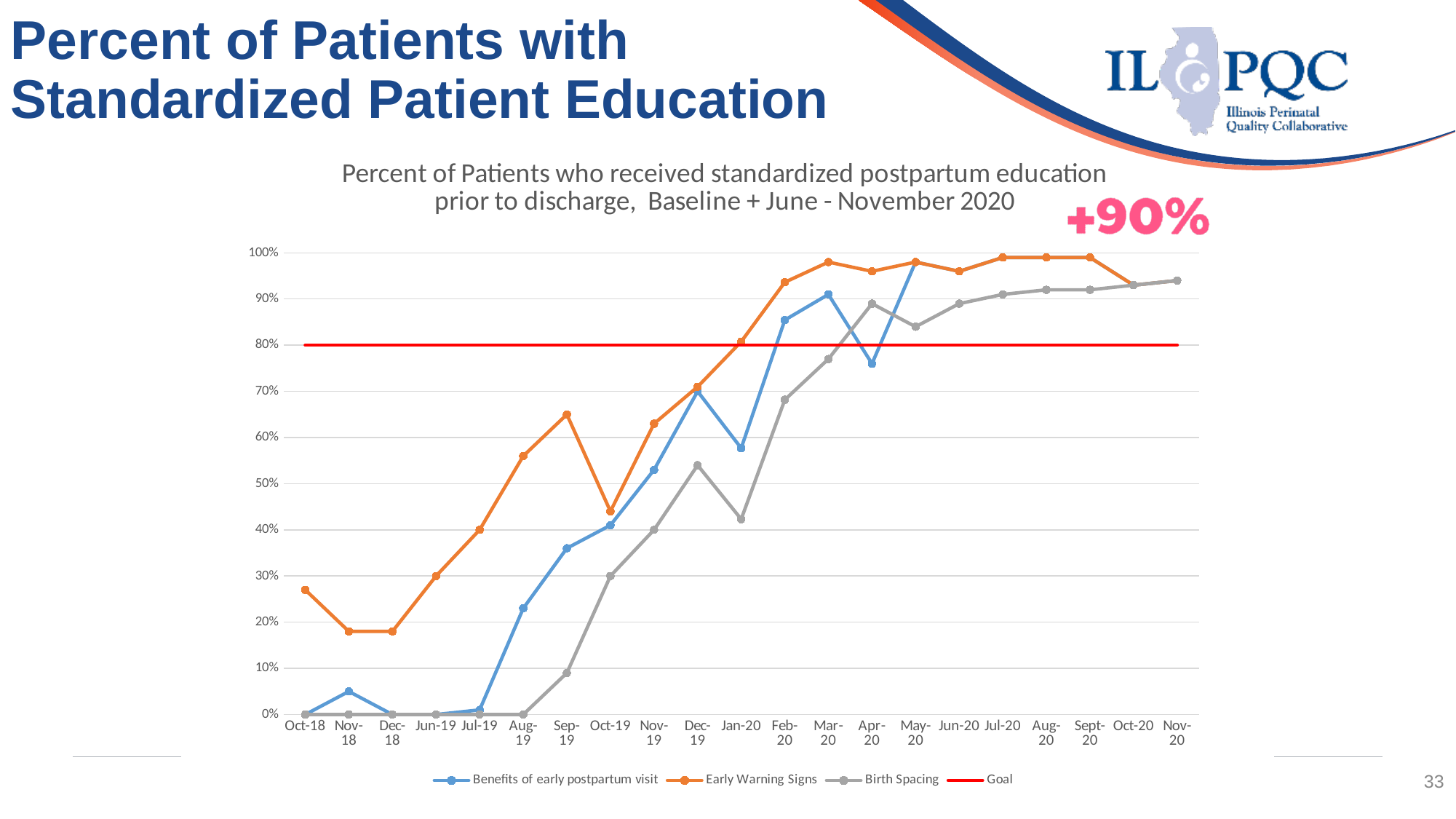
At what percentage is the Goal line drawn? 80% Does the Birth Spacing line generally rise or fall from Oct-18 to Nov-20? rise Is the value for Early Warning Signs in Oct-18 greater or less than 20%? greater How many months are shown along the x axis? 21 What is the value for Benefits of early postpartum visit in Oct-18? 0% What is the value for Birth Spacing in Aug-19? 0% How many series does the legend list? 4 In Dec-19, which is larger: Early Warning Signs or Birth Spacing? Early Warning Signs Is the value for Benefits of early postpartum visit in Apr-20 greater or less than 80%? less What kind of chart is shown on the slide? line chart Which series has the highest value in Nov-19? Early Warning Signs Is the value for Birth Spacing in Dec-19 greater or less than 50%? greater